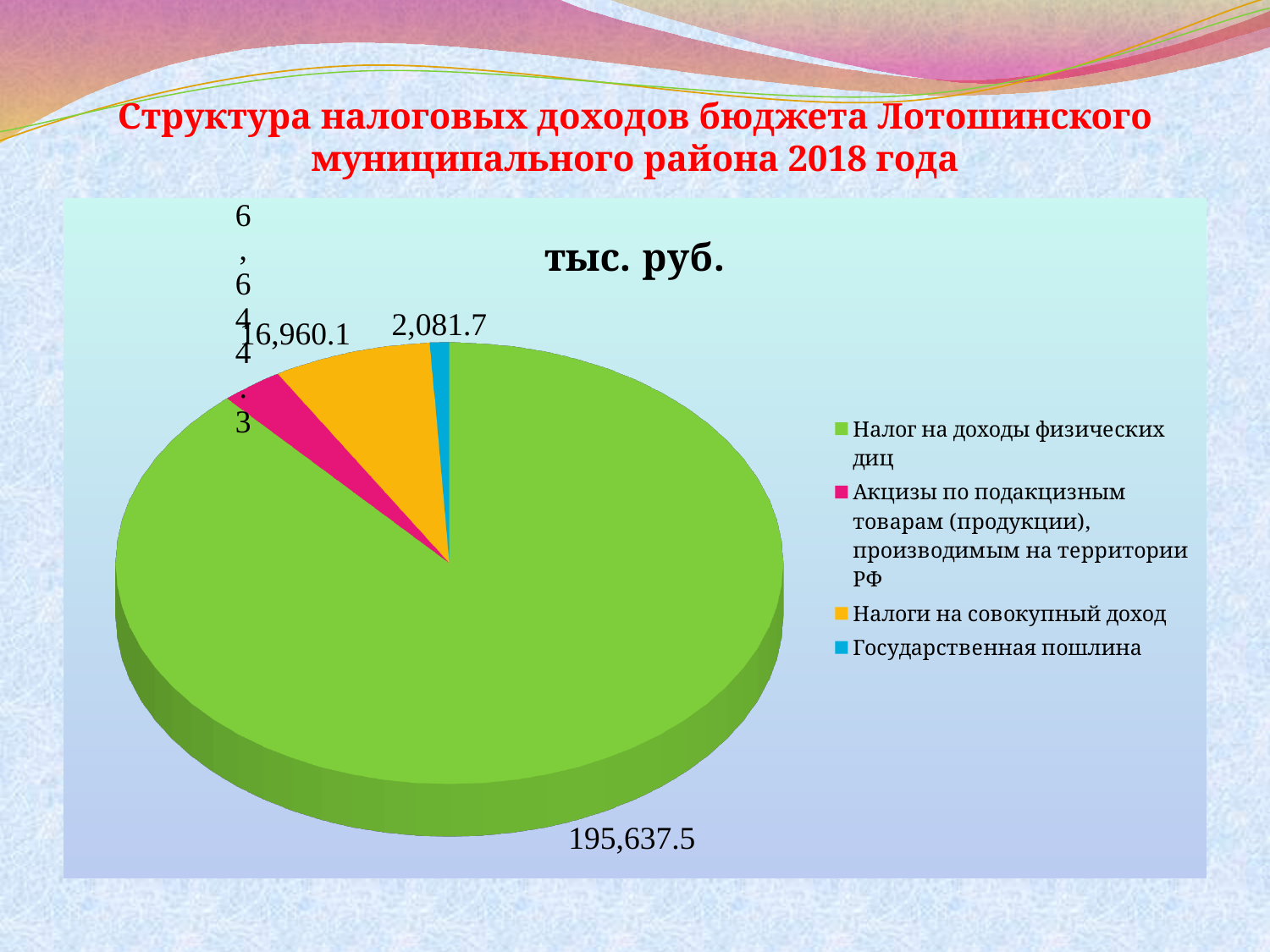
What kind of chart is shown on the slide? pie chart What is the title shown above the pie chart? тыс. руб. Which category has the largest slice of the pie? Налог на доходы физических лиц How many entries does the legend of the pie chart list? 4 How many slices does the pie chart have? 4 What is the value for Акцизы по подакцизным товарам (продукции), производимым на территории РФ? 6,644.3 Which is larger: Налоги на совокупный доход or Государственная пошлина? Налоги на совокупный доход Which category has the smallest slice of the pie? Государственная пошлина What is the value for Налоги на совокупный доход? 16,960.1 What is the value for Государственная пошлина? 2,081.7 What is the difference between the values for Налоги на совокупный доход and Государственная пошлина? 14,878.4 What is the value for Налог на доходы физических лиц? 195,637.5